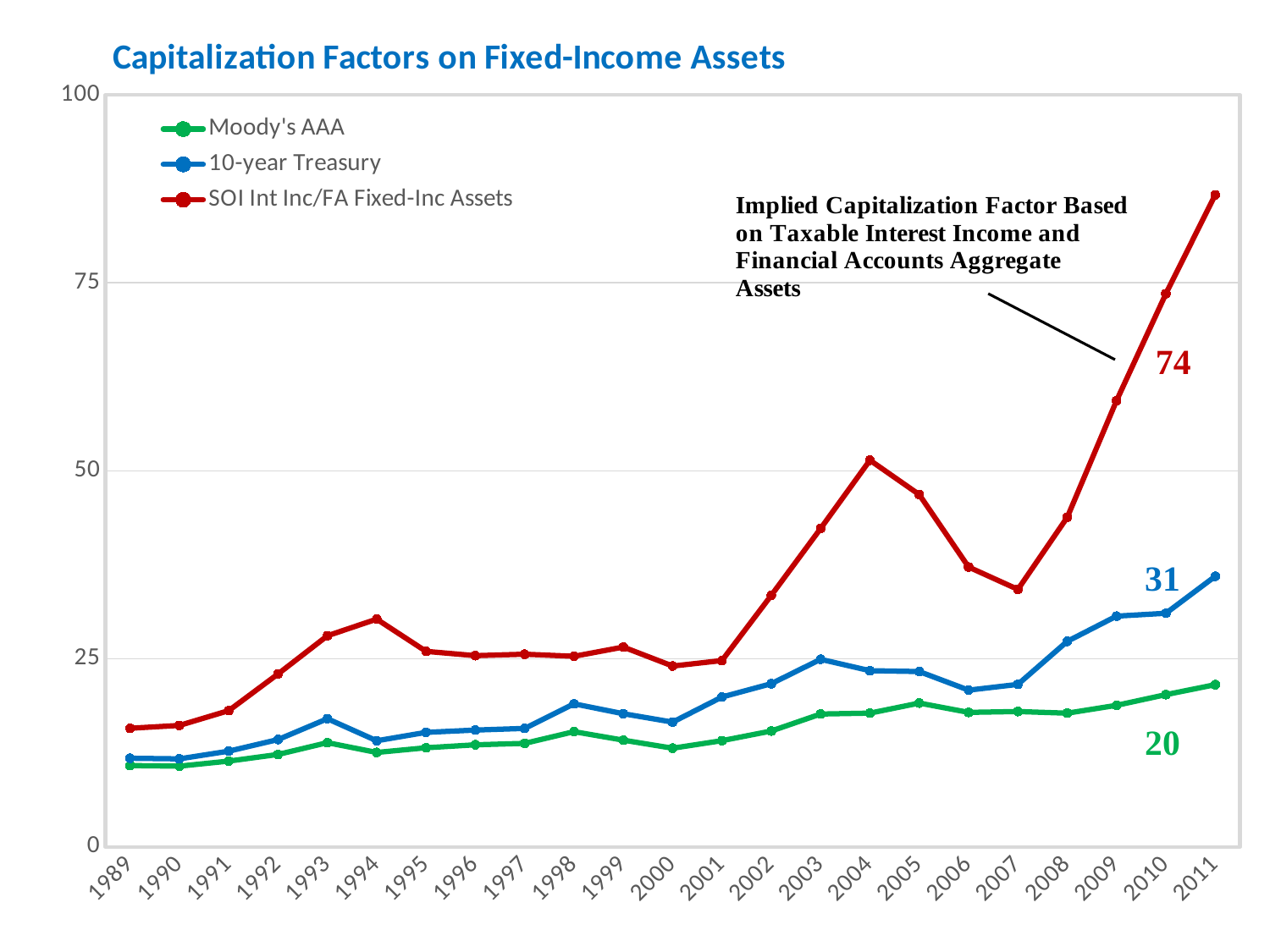
What value is printed as the data label on the 10-year Treasury line? 31 What is the difference between the printed data labels on the SOI Int Inc/FA Fixed-Inc Assets line and the 10-year Treasury line? 43 What value is printed as the data label on the SOI Int Inc/FA Fixed-Inc Assets line? 74 Does the SOI Int Inc/FA Fixed-Inc Assets line rise or fall from 2007 to 2011? rise How many series does the legend list? 3 What kind of chart is shown on the slide? line chart Is the value for SOI Int Inc/FA Fixed-Inc Assets in 2007 greater or less than 50? less Is the value for SOI Int Inc/FA Fixed-Inc Assets in 2011 greater or less than 75? greater How many years are plotted along the x axis? 23 What value is printed as the data label on the Moody's AAA line? 20 Which series has the lowest value in 2011? Moody's AAA Which series has the highest value in 2011? SOI Int Inc/FA Fixed-Inc Assets